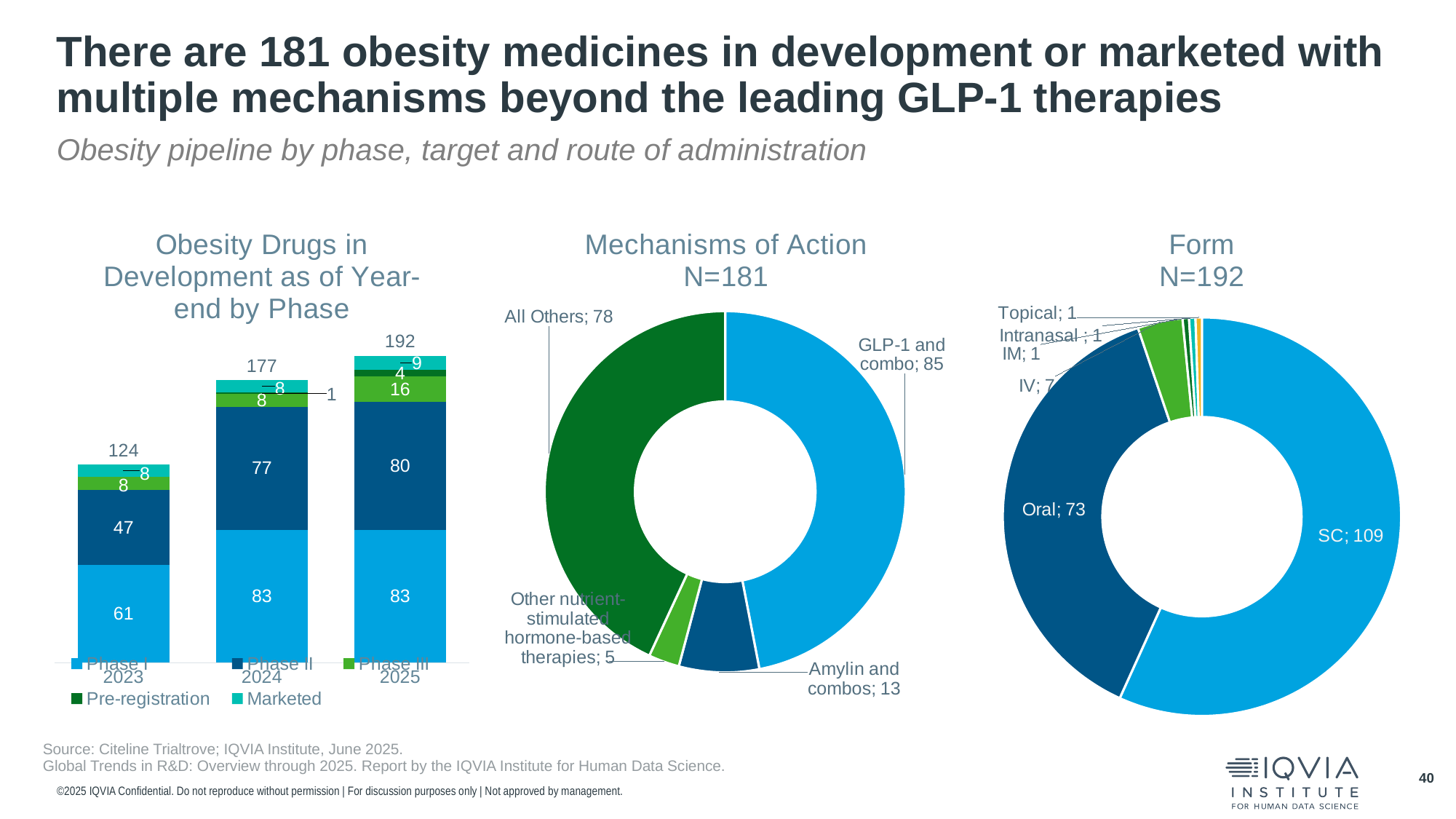
In the 'Obesity Drugs in Development as of Year-end by Phase' chart, what is the total shown above the 2024 bar? 177 In the 'Mechanisms of Action' chart, which category has the smallest value? Other nutrient-stimulated hormone-based therapies In the 'Obesity Drugs in Development as of Year-end by Phase' chart, do the bar totals rise or fall from 2023 to 2025? rise In the 'Obesity Drugs in Development as of Year-end by Phase' chart, how many years are shown on the x axis? 3 In the 'Mechanisms of Action' chart, what is the value for Amylin and combos? 13 In the 'Form' chart, what is the difference between the SC and Oral values? 36 In the 'Obesity Drugs in Development as of Year-end by Phase' chart, which year has more Phase II drugs, 2024 or 2025? 2025 In the 'Obesity Drugs in Development as of Year-end by Phase' chart, what is the total of the stacked bar for 2025? 192 In the 'Obesity Drugs in Development as of Year-end by Phase' chart, how many Phase I drugs are shown for 2025? 83 What kind of chart is the 'Form' chart? Donut (pie) chart In the 'Obesity Drugs in Development as of Year-end by Phase' chart, how many series does the legend list? 5 In the 'Mechanisms of Action' chart, which mechanism has the largest number of medicines? GLP-1 and combo